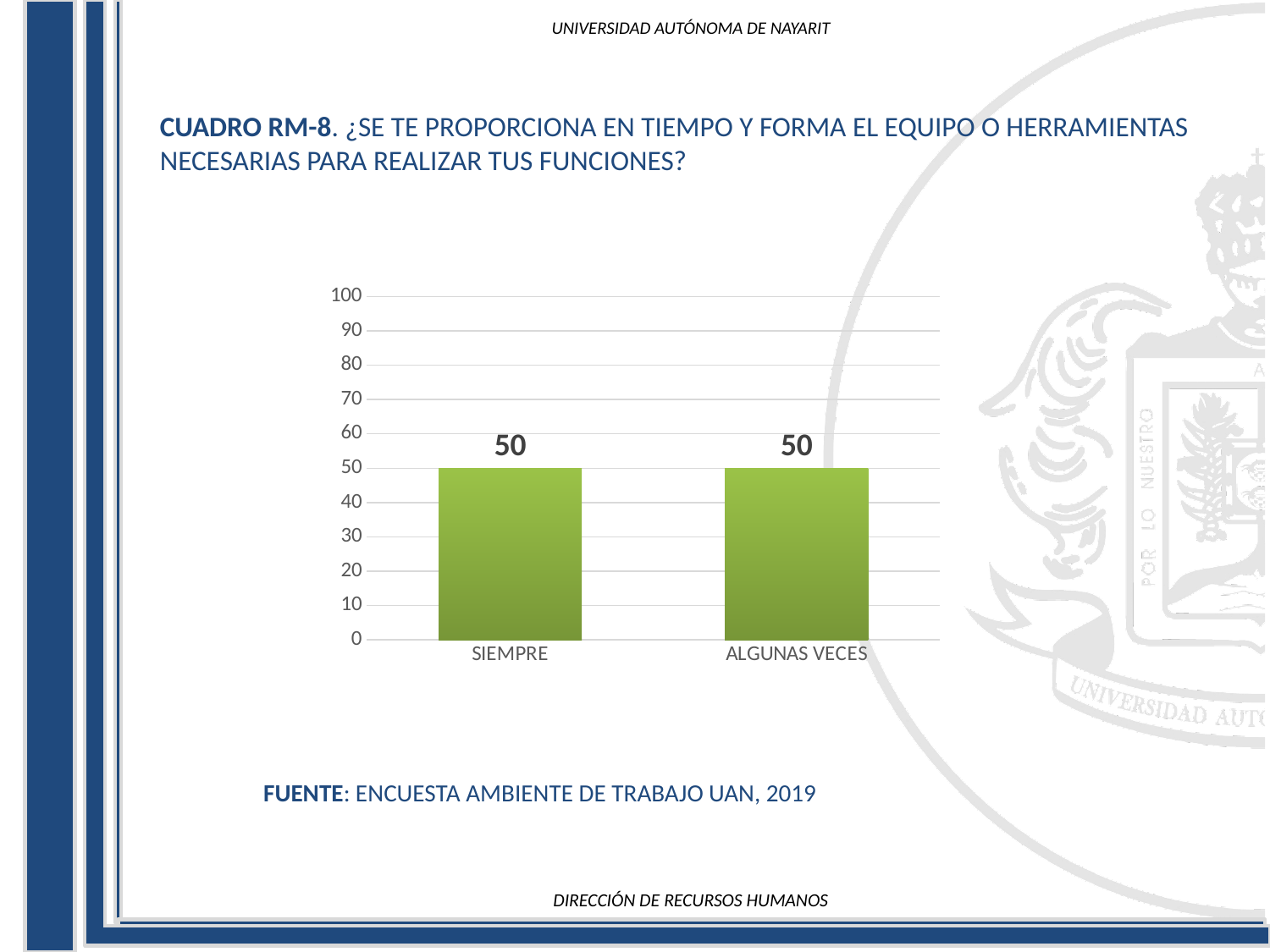
How many categories are shown on the x axis? 2 What is the difference between the values for SIEMPRE and ALGUNAS VECES? 0 What is the total of the values for SIEMPRE and ALGUNAS VECES? 100 Is the value for ALGUNAS VECES greater or less than 30? greater What is the value for SIEMPRE? 50 What is the value for ALGUNAS VECES? 50 Is the value for SIEMPRE greater or less than 70? less What kind of chart is shown on the slide? bar chart What colour are the bars in the chart? green What is the maximum value shown on the y axis? 100